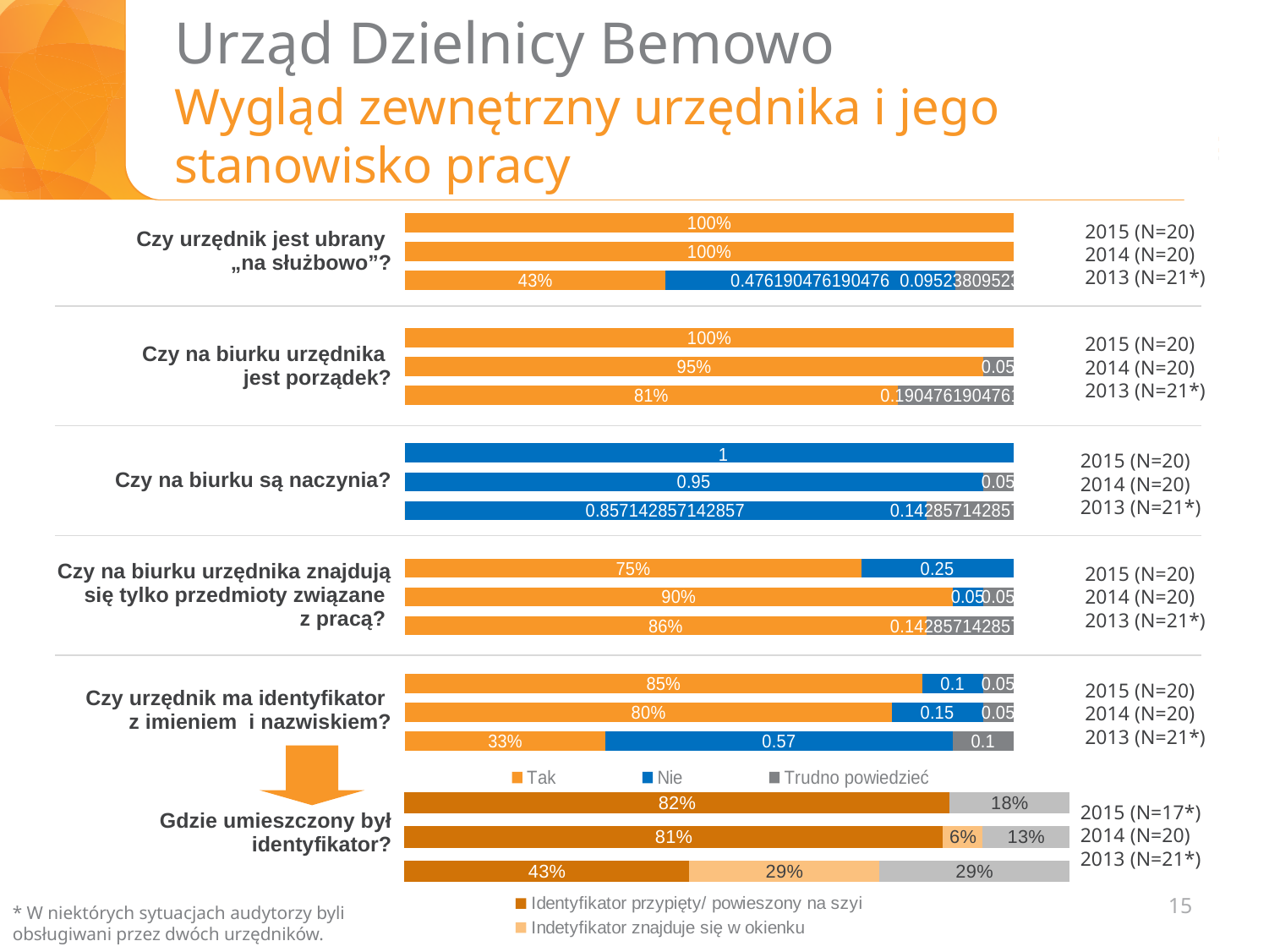
In the chart "Czy urzędnik jest ubrany „na służbowo”?", what is the "Tak" value for 2013 (N=21*)? 43% In the chart "Czy na biurku urzędnika jest porządek?", which year has the lowest "Tak" value? 2013 (N=21*) In the chart "Czy na biurku urzędnika znajdują się tylko przedmioty związane z pracą?", what is the difference between the "Tak" values for 2014 and 2015? 15% In the chart "Gdzie umieszczony był identyfikator?", is the "Identyfikator przypięty/ powieszony na szyi" value larger in 2015 (N=17*) or 2014 (N=20)? 2015 (N=17*) In the chart "Gdzie umieszczony był identyfikator?", what is the value for "Identyfikator przypięty/ powieszony na szyi" in 2013 (N=21*)? 43% In the chart "Czy na biurku urzędnika znajdują się tylko przedmioty związane z pracą?", what is the "Tak" value for 2015 (N=20)? 75% In the chart "Czy urzędnik jest ubrany „na służbowo”?", what is the "Tak" value for 2015 (N=20)? 100% In the chart "Czy urzędnik ma identyfikator z imieniem i nazwiskiem?", which year has the highest "Tak" value? 2015 (N=20) In the chart "Czy na biurku są naczynia?", what is the "Nie" value for 2014 (N=20)? 0.95 In the chart "Czy na biurku urzędnika jest porządek?", what is the "Tak" value for 2014 (N=20)? 95% How many series does the legend with "Tak", "Nie" and "Trudno powiedzieć" list? 3 In the chart "Czy urzędnik ma identyfikator z imieniem i nazwiskiem?", what is the "Nie" value for 2013 (N=21*)? 0.57